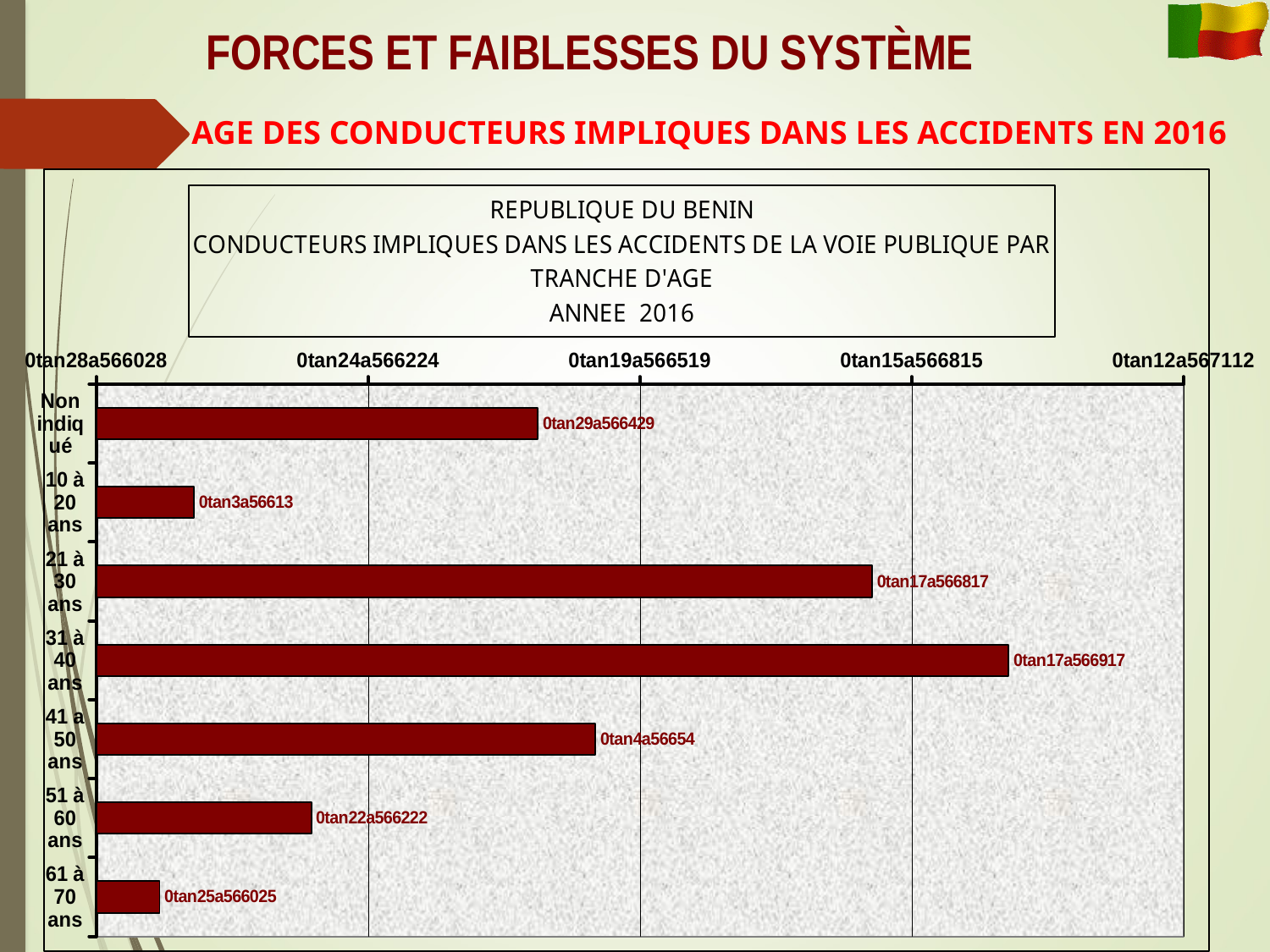
Which has the larger value: 10 à 20 ans or 41 à 50 ans? 41 à 50 ans Which has the larger value: Non indiqué or 51 à 60 ans? Non indiqué How many age categories are plotted in the chart? 7 Which country is named in the chart's title? REPUBLIQUE DU BENIN Which year does the chart's title say the data refers to? 2016 Which age category has the longest bar in the chart? 31 à 40 ans Which has the larger value: 21 à 30 ans or 41 à 50 ans? 21 à 30 ans Going from the 31 à 40 ans category down to the 61 à 70 ans category, do the bar values rise or fall? fall Which age category has the shortest bar in the chart? 61 à 70 ans What kind of chart is shown on the slide? bar chart